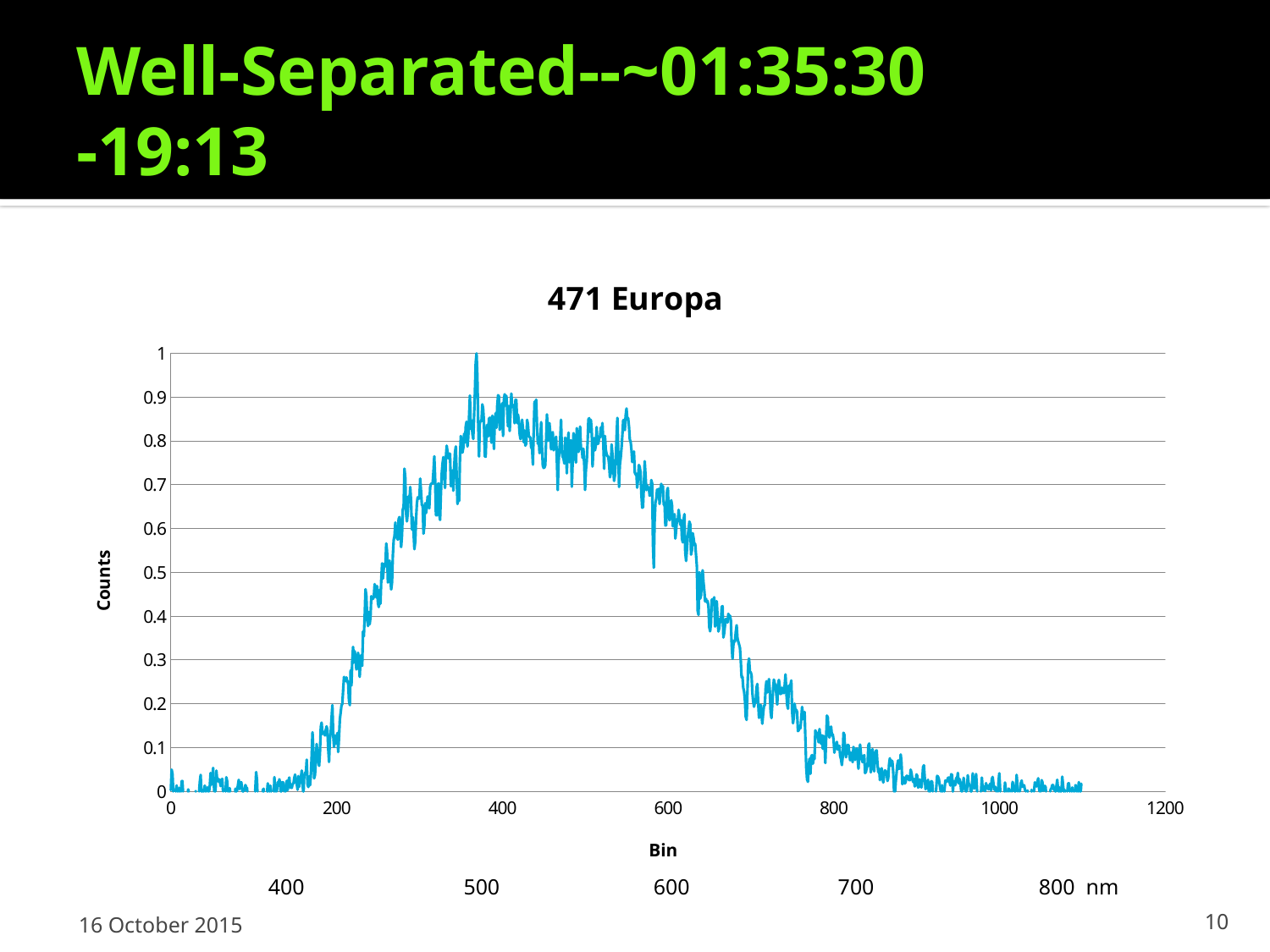
Is the value at bin 200 greater or less than 0.5? less Is the value at bin 400 greater or less than 0.5? greater What kind of chart is shown on the slide? line chart Is the value at bin 800 greater or less than 0.3? less What is the peak value reached by the line? 1 Is the value at bin 400 larger or smaller than the value at bin 800? larger Do the values rise or fall along the x axis between bin 600 and bin 1000? fall What is the title of the chart? 471 Europa Do the values rise or fall along the x axis between bin 200 and bin 400? rise What is the label of the y axis? Counts